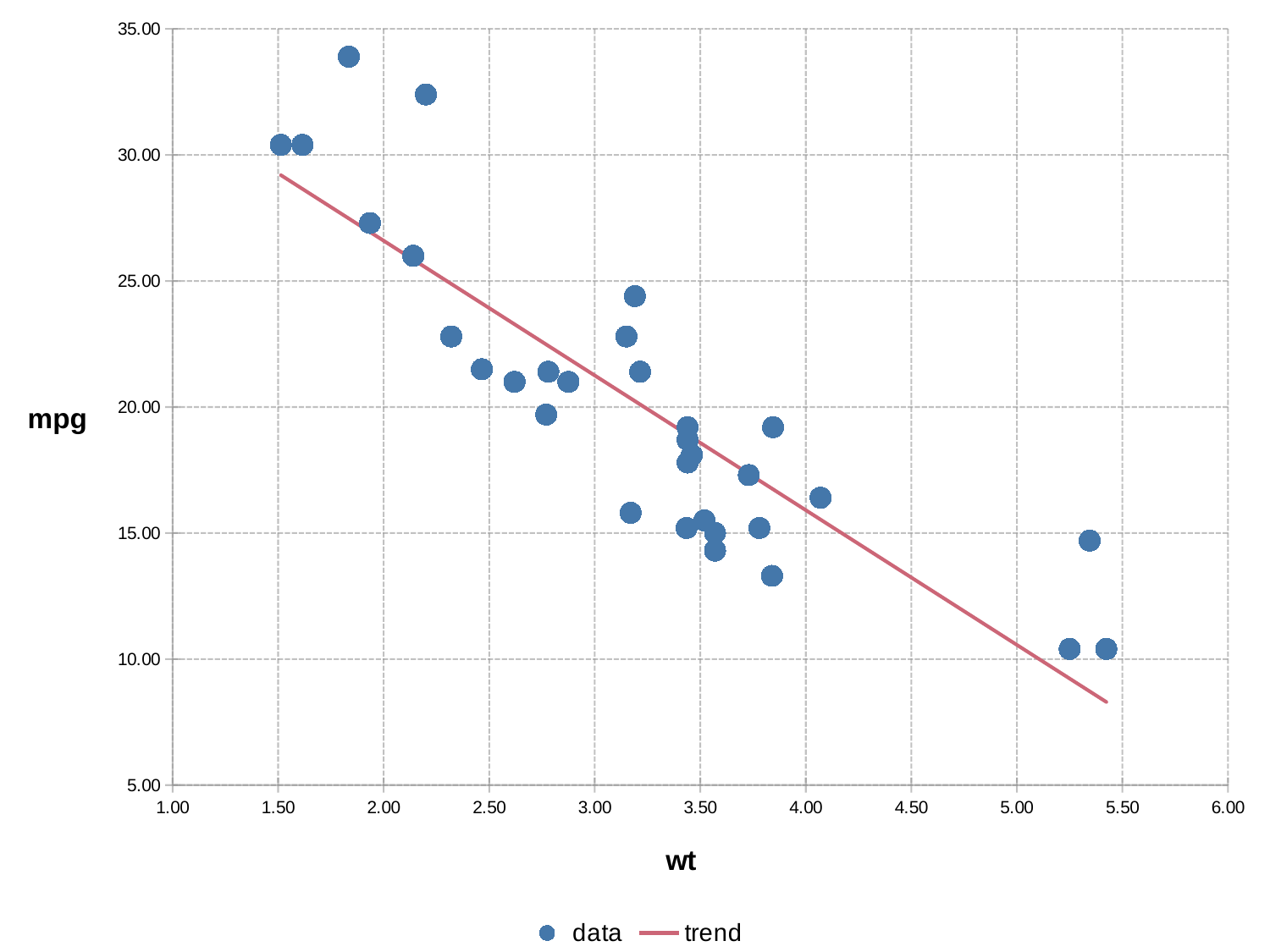
What are the two entries in the legend? data, trend How many series does the legend list? 2 Which has the higher mpg: the data point near wt 1.83 or the data point near wt 5.42? the point near wt 1.83 What kind of chart is shown on the slide? scatter plot Is the mpg value for the data point near wt 2.14 greater or less than 25? greater What is the title of the vertical axis? mpg Is the mpg value for the data point near wt 4.07 greater or less than 20? less Does the trend line slope upward or downward from left to right? downward As wt increases along the x axis, do the mpg values generally rise or fall? fall Are the mpg values for the two data points near wt 5.25 and 5.42 greater or less than 15? less